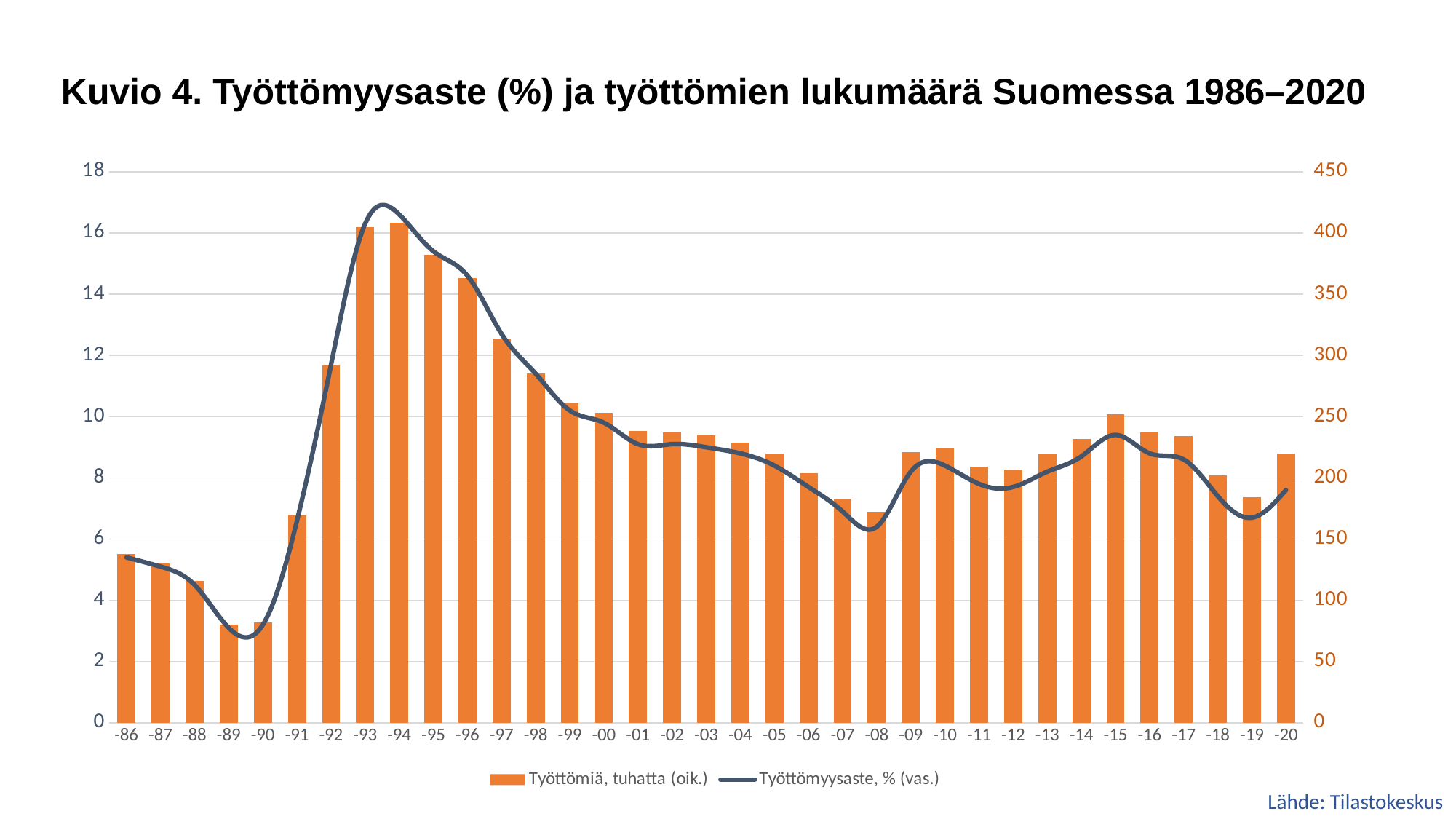
Is the bar value (Työttömiä, tuhatta) for -08 greater or less than 200? less How many years (categories) are plotted along the x axis? 35 What is the title of the chart? Kuvio 4. Työttömyysaste (%) ja työttömien lukumäärä Suomessa 1986–2020 Do the bar values (Työttömiä, tuhatta) rise or fall overall from -94 to -08? fall Is the bar value (Työttömiä, tuhatta) for -86 greater or less than 150? less Is the line value (Työttömyysaste, %) for -97 greater or less than 12? greater How many series does the legend list? 2 Which year has the larger bar (Työttömiä, tuhatta): -93 or -86? -93 What kind of chart is shown on the slide? A combined bar and line chart Which year has the higher unemployment rate (Työttömyysaste, %) on the line: -97 or -07? -97